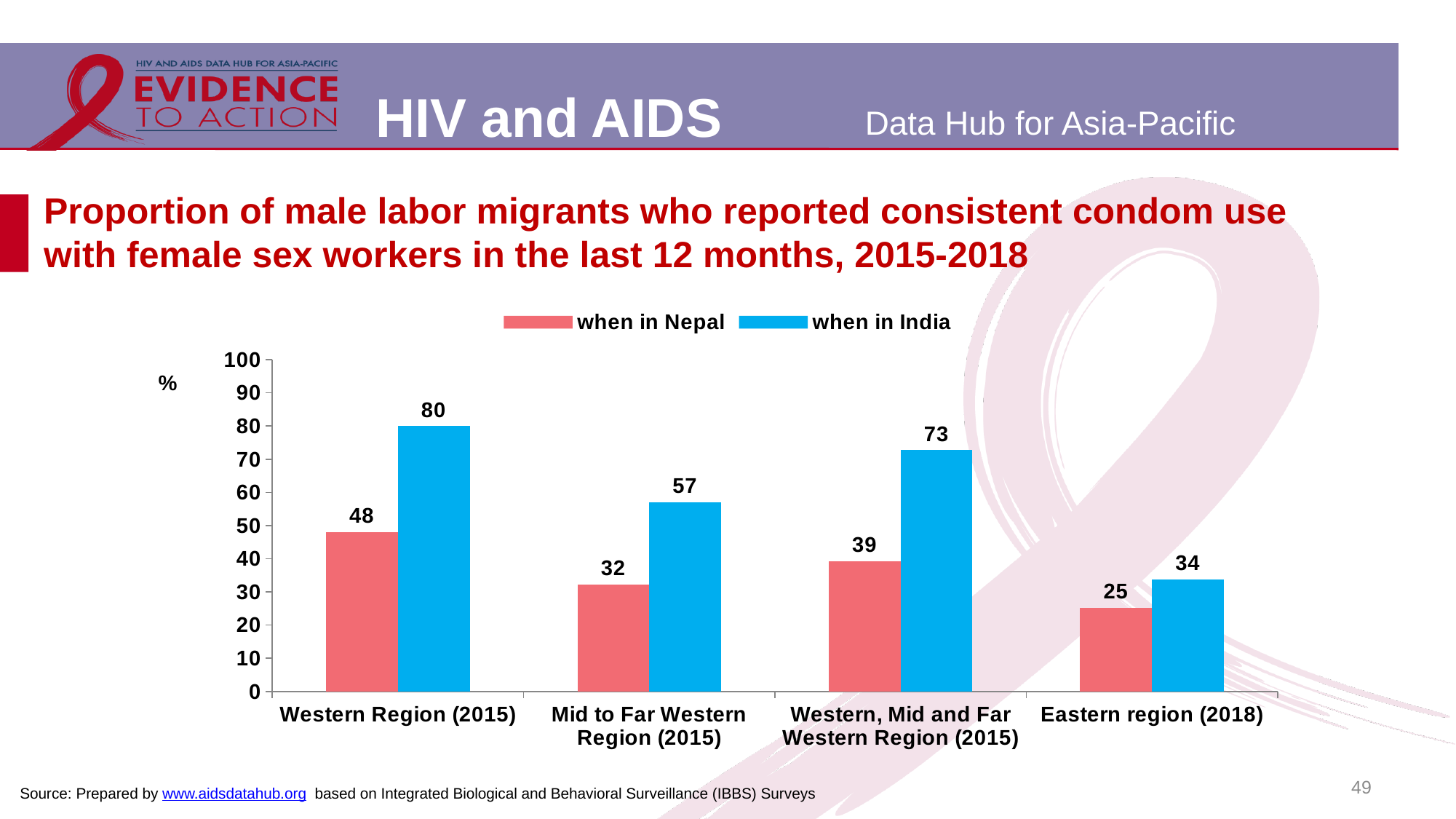
Which category has the lowest 'when in Nepal' value? Eastern region (2018) Which is larger for Mid to Far Western Region (2015): the 'when in Nepal' value or the 'when in India' value? when in India What is the value for 'when in Nepal' for Mid to Far Western Region (2015)? 32 What is the value for 'when in India' for Western Region (2015)? 80 What is the value for 'when in Nepal' for Eastern region (2018)? 25 Is the 'when in India' value for Eastern region (2018) greater or less than 50? less How many series does the legend list? 2 How many categories are shown on the x axis? 4 What is the difference between the 'when in India' and 'when in Nepal' values for Western, Mid and Far Western Region (2015)? 34 Which colour represents the 'when in India' series? Blue What kind of chart is shown on the slide? Bar chart Which category has the highest 'when in India' value? Western Region (2015)